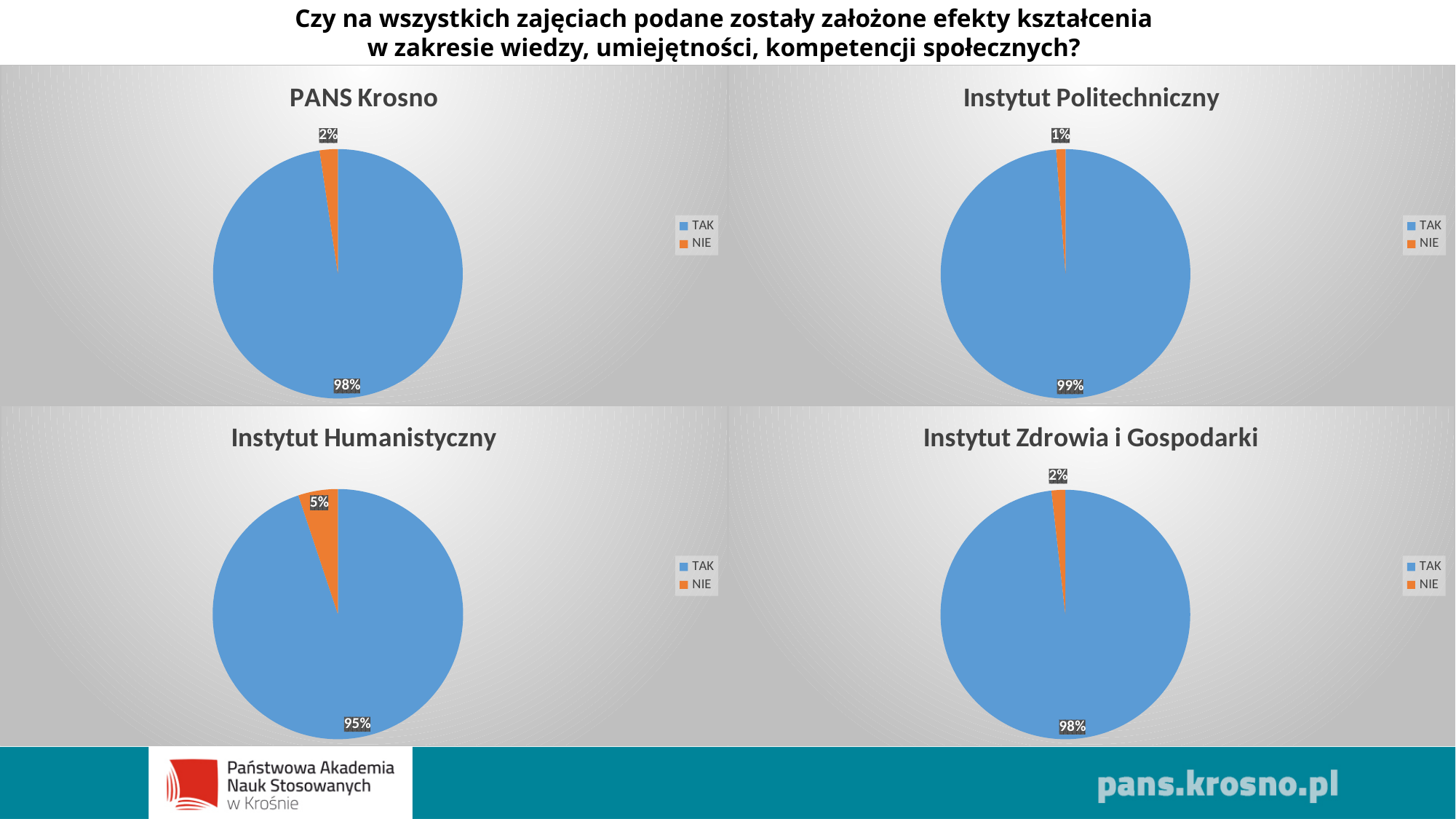
In the 'PANS Krosno' chart, what colour is the TAK slice? Blue What type of chart is the 'PANS Krosno' chart? Pie chart In the 'Instytut Zdrowia i Gospodarki' chart, which slice is the smallest? NIE How many entries does the legend of the 'Instytut Politechniczny' chart list? 2 In the 'Instytut Politechniczny' chart, what percentage is shown for NIE? 1% In the 'Instytut Humanistyczny' chart, which slice is the largest? TAK In the 'Instytut Humanistyczny' chart, what is the difference between the TAK and NIE percentages? 90% In the 'Instytut Zdrowia i Gospodarki' chart, what percentage is shown for TAK? 98% In the 'Instytut Humanistyczny' chart, what percentage is shown for NIE? 5% In the 'Instytut Politechniczny' chart, what percentage is shown for TAK? 99% In the 'PANS Krosno' chart, what percentage is shown for TAK? 98% In the 'PANS Krosno' chart, what percentage is shown for NIE? 2%